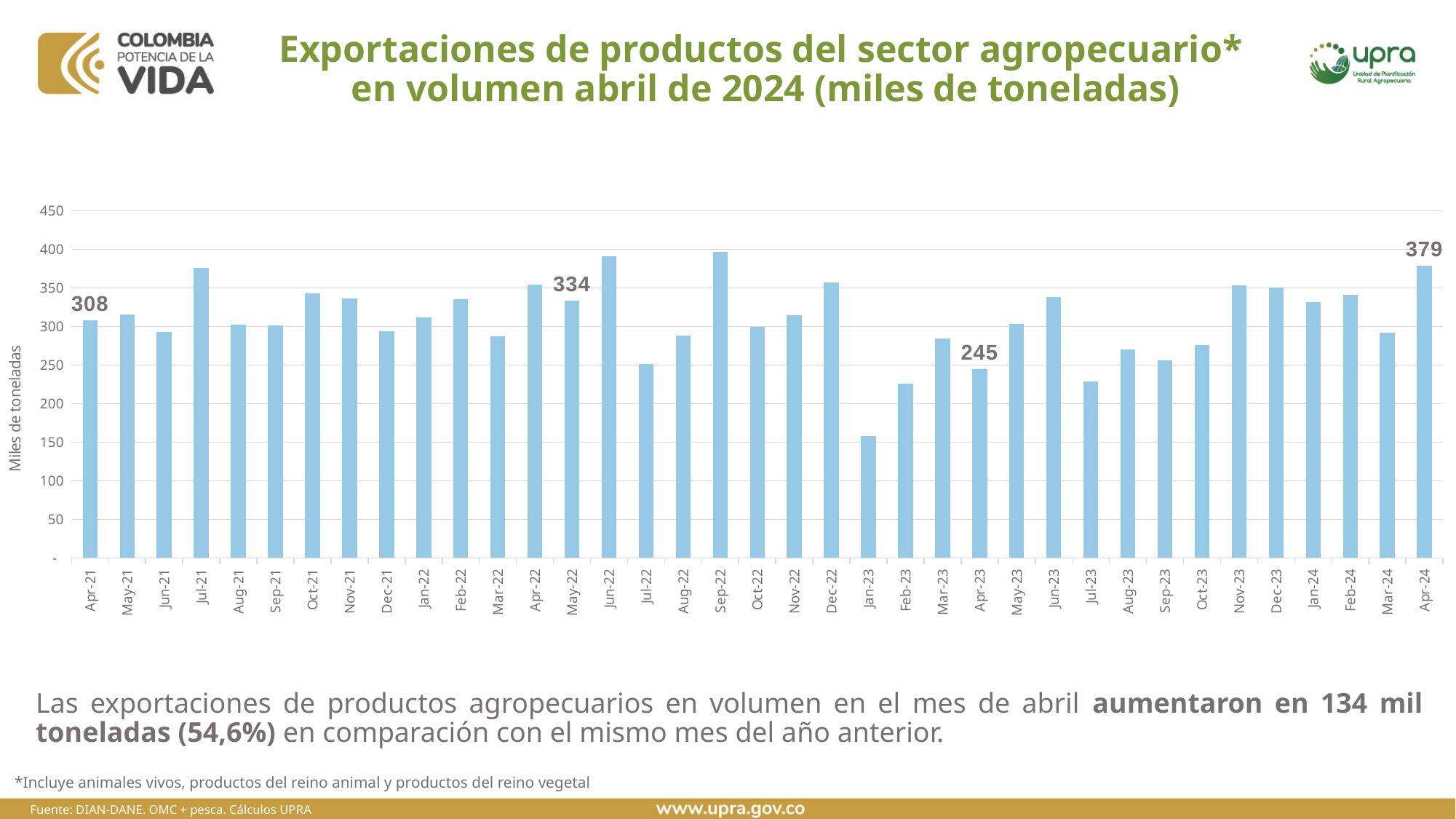
What is the value for Apr-23? 245 What is the value for May-22? 334 What is the difference between the values for Apr-24 and Apr-23? 134 Which is larger, the value for Apr-24 or the value for Apr-21? Apr-24 What is the value for Apr-24? 379 How many months are plotted on the chart? 37 What kind of chart is shown? bar chart Which month has the lowest value? Jan-23 Is the value for Jul-21 greater or less than 350? greater Is the value for Jan-23 greater or less than 200? less What is the difference between the values for Apr-24 and Apr-21? 71 What is the value for Apr-21? 308